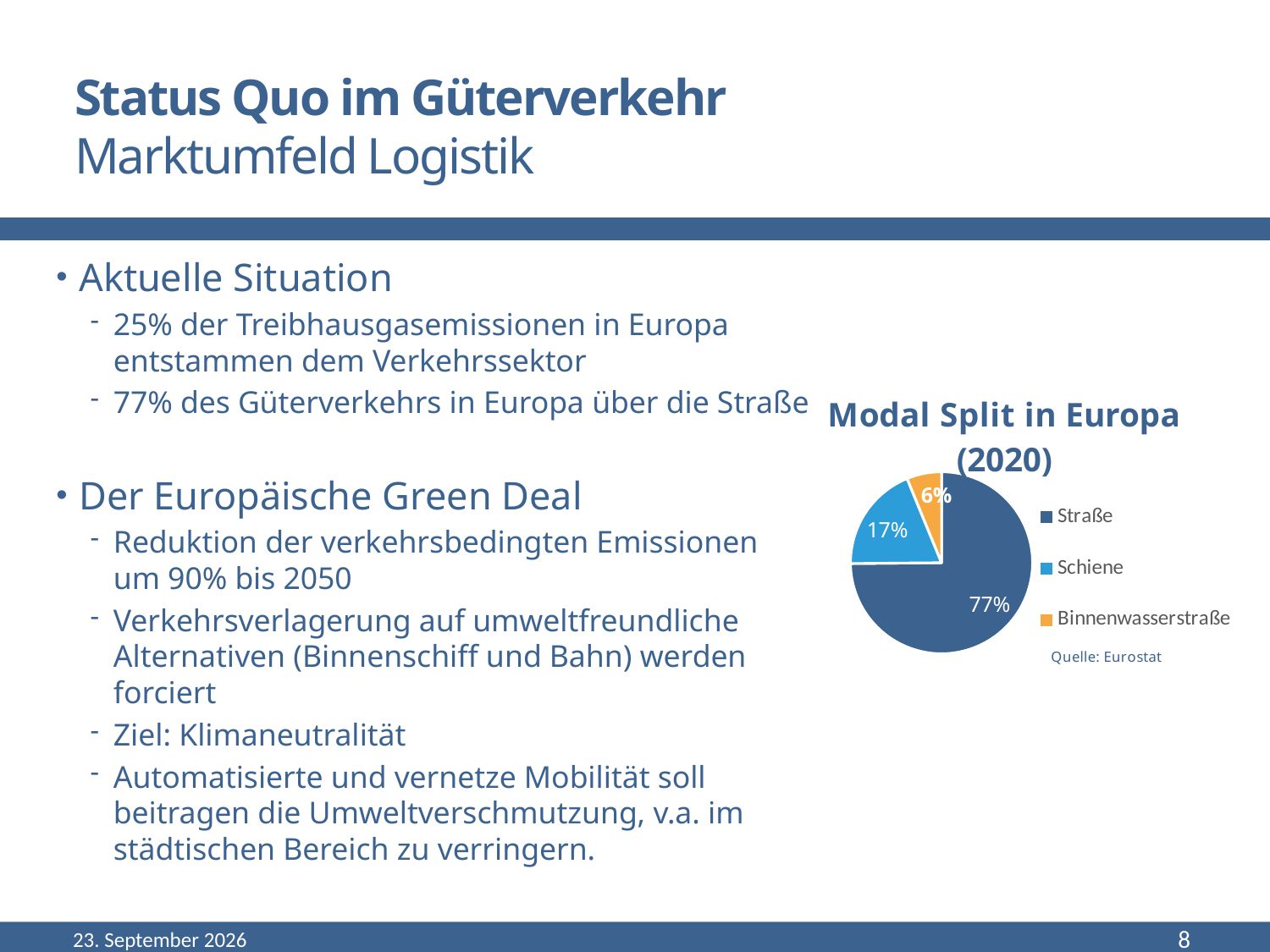
What source is cited below the chart legend? Eurostat What is the difference in percentage points between the Schiene and Binnenwasserstraße shares? 11 What share of the pie does Schiene have? 17% What is the title of the chart? Modal Split in Europa (2020) Which category has the smallest share of the pie? Binnenwasserstraße What kind of chart is shown on the slide? pie chart How many categories does the pie chart show? 3 What is the difference in percentage points between the Straße and Schiene shares? 60 What share of the pie does Binnenwasserstraße have? 6% Which is larger, the share for Schiene or the share for Binnenwasserstraße? Schiene What share of the pie does Straße have? 77% Which category has the largest share of the pie? Straße